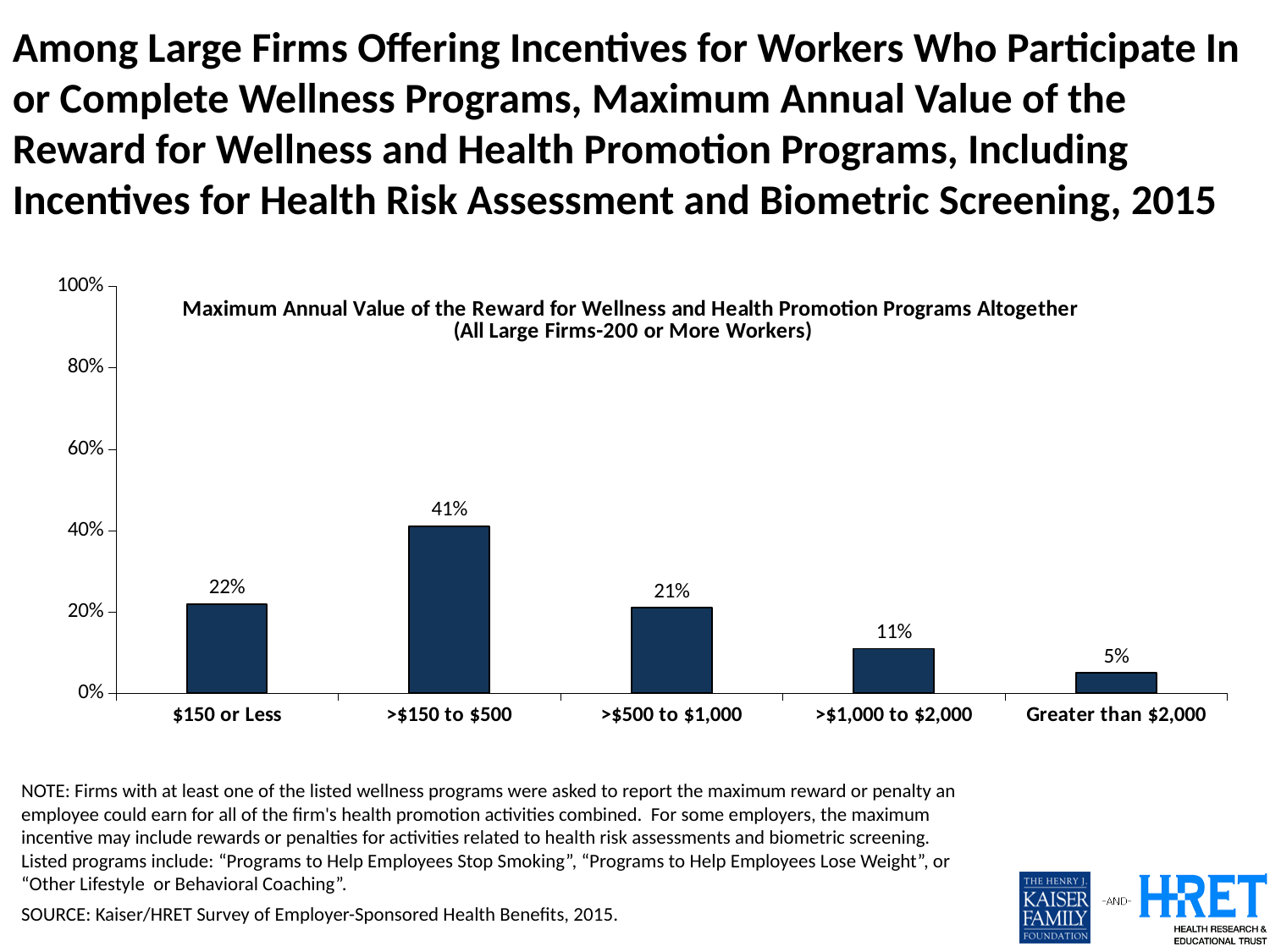
Is the value for ">$150 to $500" greater or less than 40%? greater What is the difference between the values for ">$150 to $500" and ">$500 to $1,000"? 20% Which is larger, the value for "$150 or Less" or the value for ">$1,000 to $2,000"? $150 or Less What is the difference between the values for ">$1,000 to $2,000" and "Greater than $2,000"? 6% What percentage of large firms report a maximum annual reward value of >$150 to $500? 41% What is the maximum value shown on the y axis of the chart? 100% What kind of chart is shown on the slide? Bar chart Which category has the lowest value in the chart? Greater than $2,000 Which category has the highest value in the chart? >$150 to $500 How many categories are shown on the x axis of the chart? 5 What is the value shown for the "$150 or Less" category? 22% What percentage is shown for "Greater than $2,000"? 5%